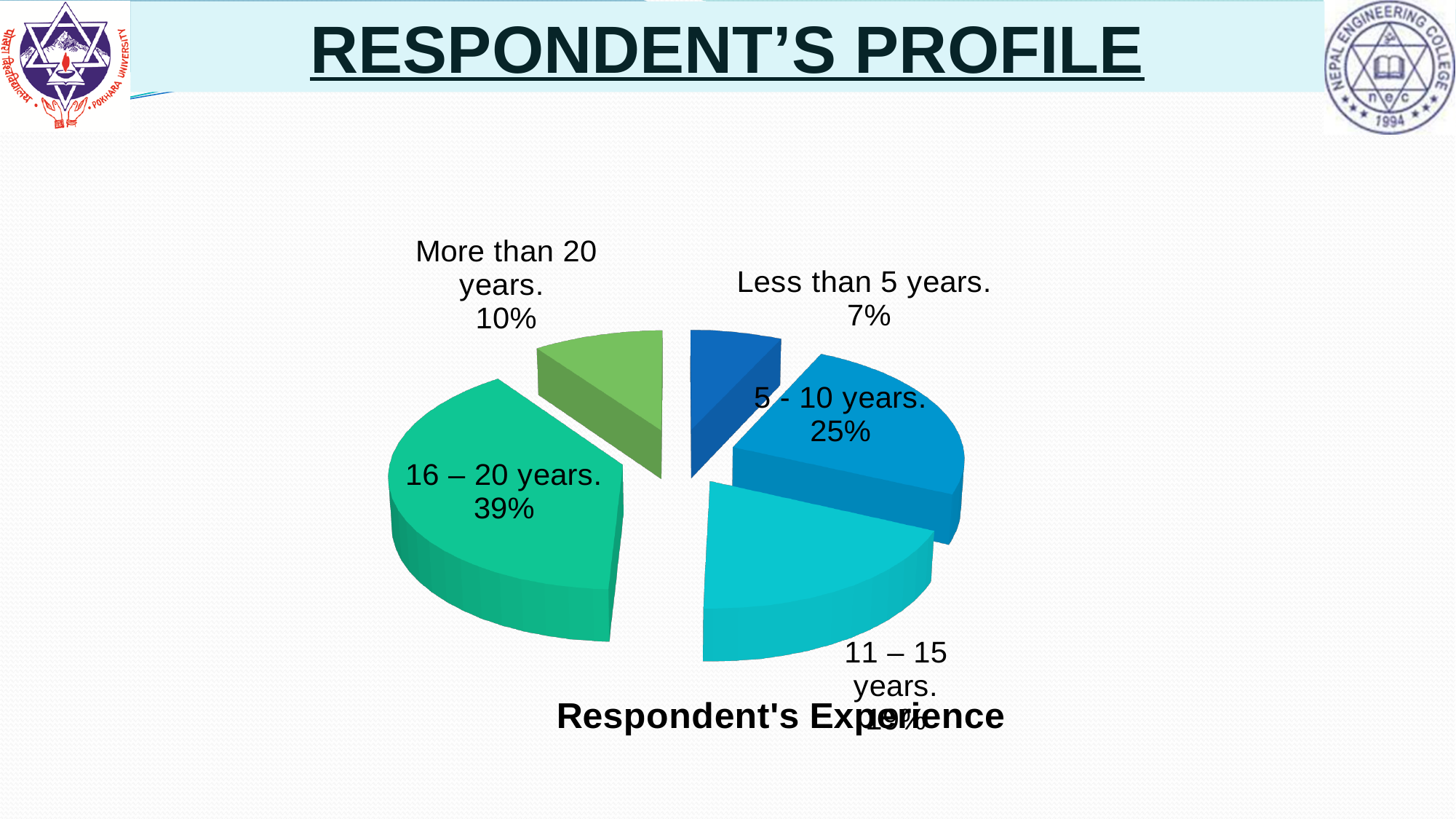
What kind of chart is shown on the slide? pie chart Which has a larger share: 5 - 10 years or More than 20 years? 5 - 10 years. What share of respondents have more than 20 years of experience? 10% How many percentage points larger is the More than 20 years share than the Less than 5 years share? 3% How many percentage points larger is the 16 – 20 years share than the 5 - 10 years share? 14% How many experience categories are shown in the pie chart? 5 What share of respondents have 5 - 10 years of experience? 25% What is the title of the chart? Respondent's Experience Which experience category has the largest share of respondents? 16 – 20 years. What share of respondents have less than 5 years of experience? 7% What share of respondents have 16 – 20 years of experience? 39% Which experience category has the smallest share of respondents? Less than 5 years.